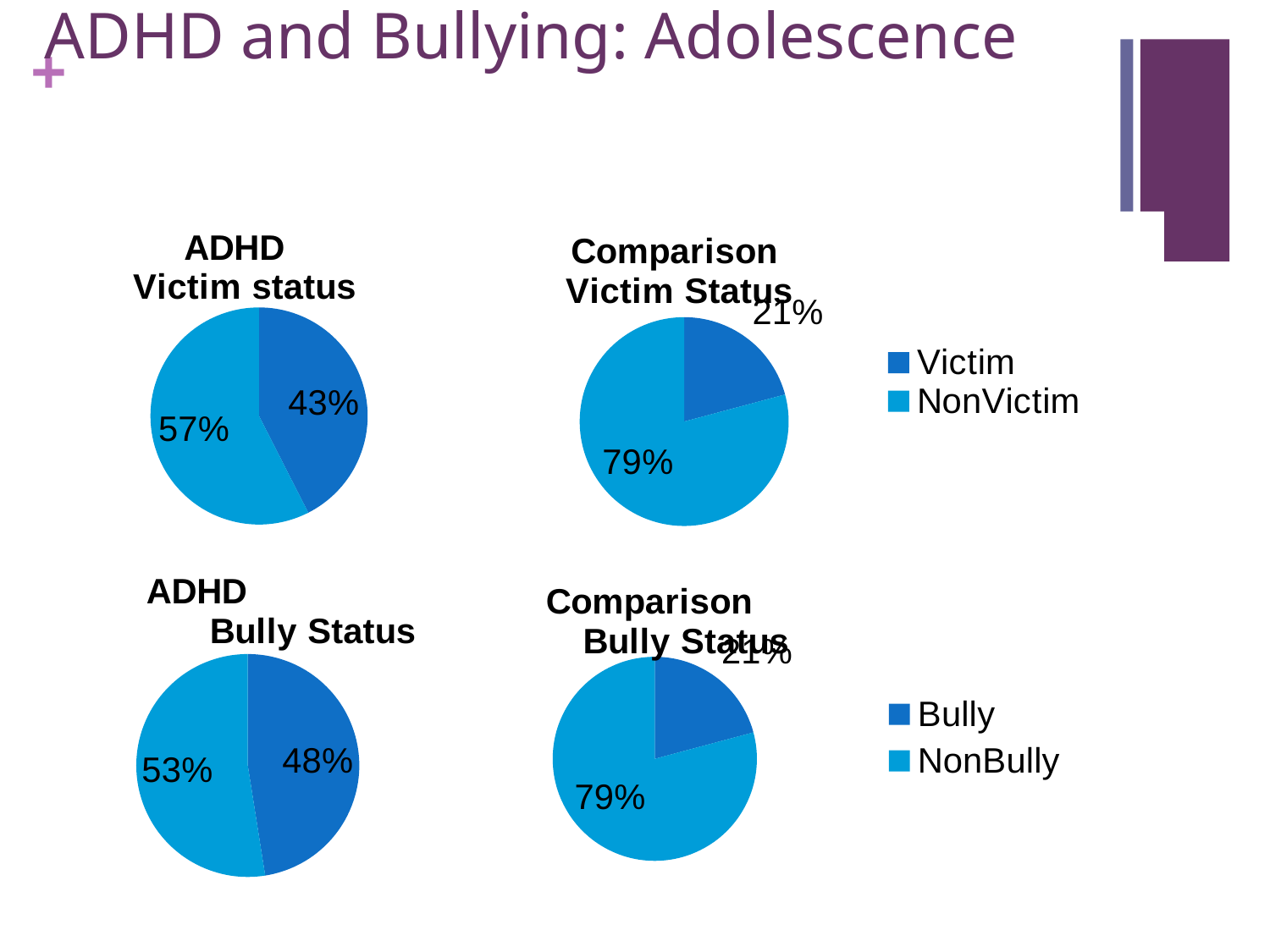
In the "ADHD Victim status" chart, what share of the pie is labelled Victim? 43% Which is larger: the Bully share in the "ADHD Bully Status" chart or the Bully share in the "Comparison Bully Status" chart? ADHD Bully Status What type of chart is the "Comparison Victim Status" chart? Pie chart In the "ADHD Victim status" chart, which slice is the smallest? Victim In the "Comparison Victim Status" chart, what percentage is shown for the NonVictim slice? 79% In the "ADHD Victim status" chart, what share of the pie is labelled NonVictim? 57% What is the difference between the Victim percentage in the "ADHD Victim status" chart and the Victim percentage in the "Comparison Victim Status" chart? 22% In the "Comparison Victim Status" chart, what percentage is shown for the Victim slice? 21% In the "ADHD Bully Status" chart, what percentage is shown for the NonBully slice? 53% In the "Comparison Bully Status" chart, which slice is the largest? NonBully In the "ADHD Bully Status" chart, what percentage is shown for the Bully slice? 48% In the "Comparison Bully Status" chart, what percentage is shown for the Bully slice? 21%